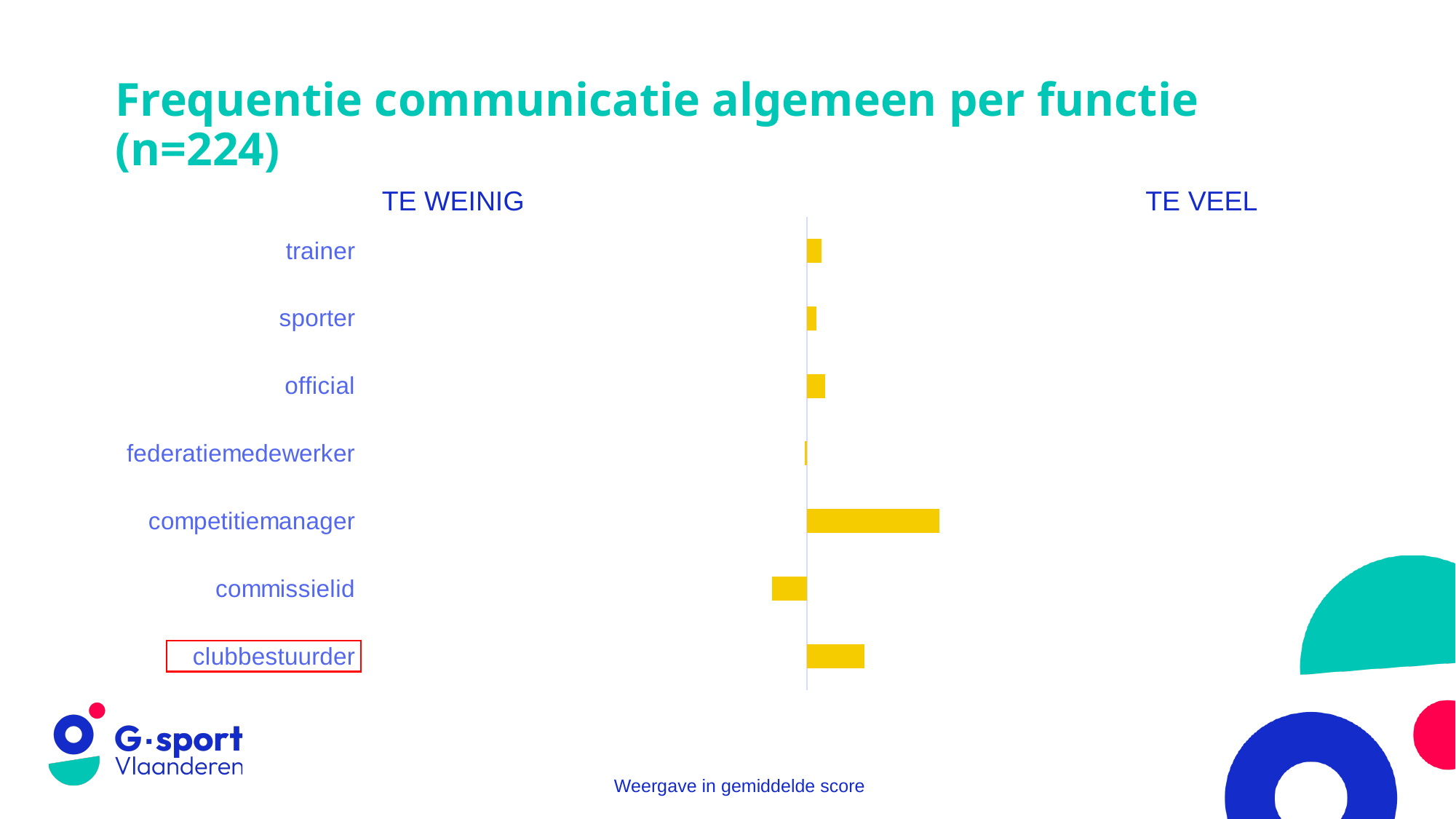
Which function has the shortest bar in the chart? federatiemedewerker Which function has the lowest value (the only bar extending towards 'TE WEINIG')? commissielid What is the title of the chart on the slide? Frequentie communicatie algemeen per functie (n=224) How many functions (categories) are plotted in the chart? 7 Which has the larger value, trainer or commissielid? trainer What are the two labels shown at the left and right ends of the chart's horizontal axis? TE WEINIG and TE VEEL Which has the larger value, clubbestuurder or sporter? clubbestuurder Which function has the highest value (longest bar towards 'TE VEEL')? competitiemanager Which has the larger value, official or federatiemedewerker? official What kind of chart is shown on the slide? bar chart